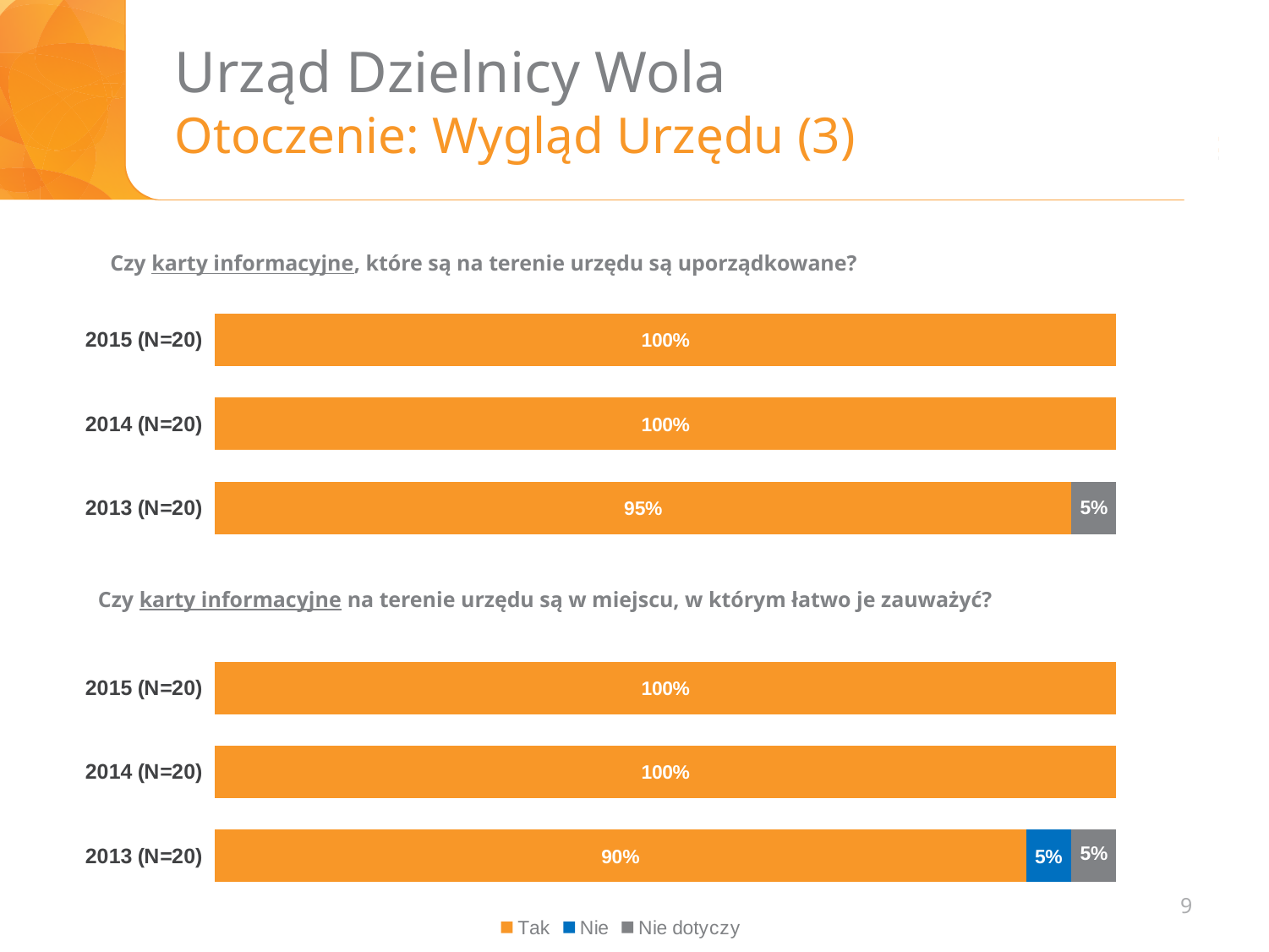
How many series does the legend at the bottom of the slide list? 3 Which is larger: the "Tak" value for 2013 (N=20) in the top chart or the "Tak" value for 2013 (N=20) in the bottom chart? The top chart (95%) How many year categories does the bottom chart ("Czy karty informacyjne na terenie urzędu są w miejscu, w którym łatwo je zauważyć?") show? 3 In the top chart ("Czy karty informacyjne, które są na terenie urzędu są uporządkowane?"), what is the "Nie dotyczy" value for 2013 (N=20)? 5% In the top chart ("Czy karty informacyjne, które są na terenie urzędu są uporządkowane?"), what is the difference between the "Tak" value for 2014 (N=20) and for 2013 (N=20)? 5% In the bottom chart ("Czy karty informacyjne na terenie urzędu są w miejscu, w którym łatwo je zauważyć?"), what is the "Tak" value for 2014 (N=20)? 100% In the bottom chart ("Czy karty informacyjne na terenie urzędu są w miejscu, w którym łatwo je zauważyć?"), what is the "Tak" value for 2013 (N=20)? 90% In the bottom chart ("Czy karty informacyjne na terenie urzędu są w miejscu, w którym łatwo je zauważyć?"), what is the "Nie" value for 2013 (N=20)? 5% What type of chart is the top chart ("Czy karty informacyjne, które są na terenie urzędu są uporządkowane?")? Stacked horizontal bar chart In the top chart ("Czy karty informacyjne, które są na terenie urzędu są uporządkowane?"), what is the "Tak" value for 2015 (N=20)? 100% In the bottom chart ("Czy karty informacyjne na terenie urzędu są w miejscu, w którym łatwo je zauważyć?"), which year has the lowest "Tak" value? 2013 (N=20) In the top chart ("Czy karty informacyjne, które są na terenie urzędu są uporządkowane?"), what is the "Tak" value for 2013 (N=20)? 95%